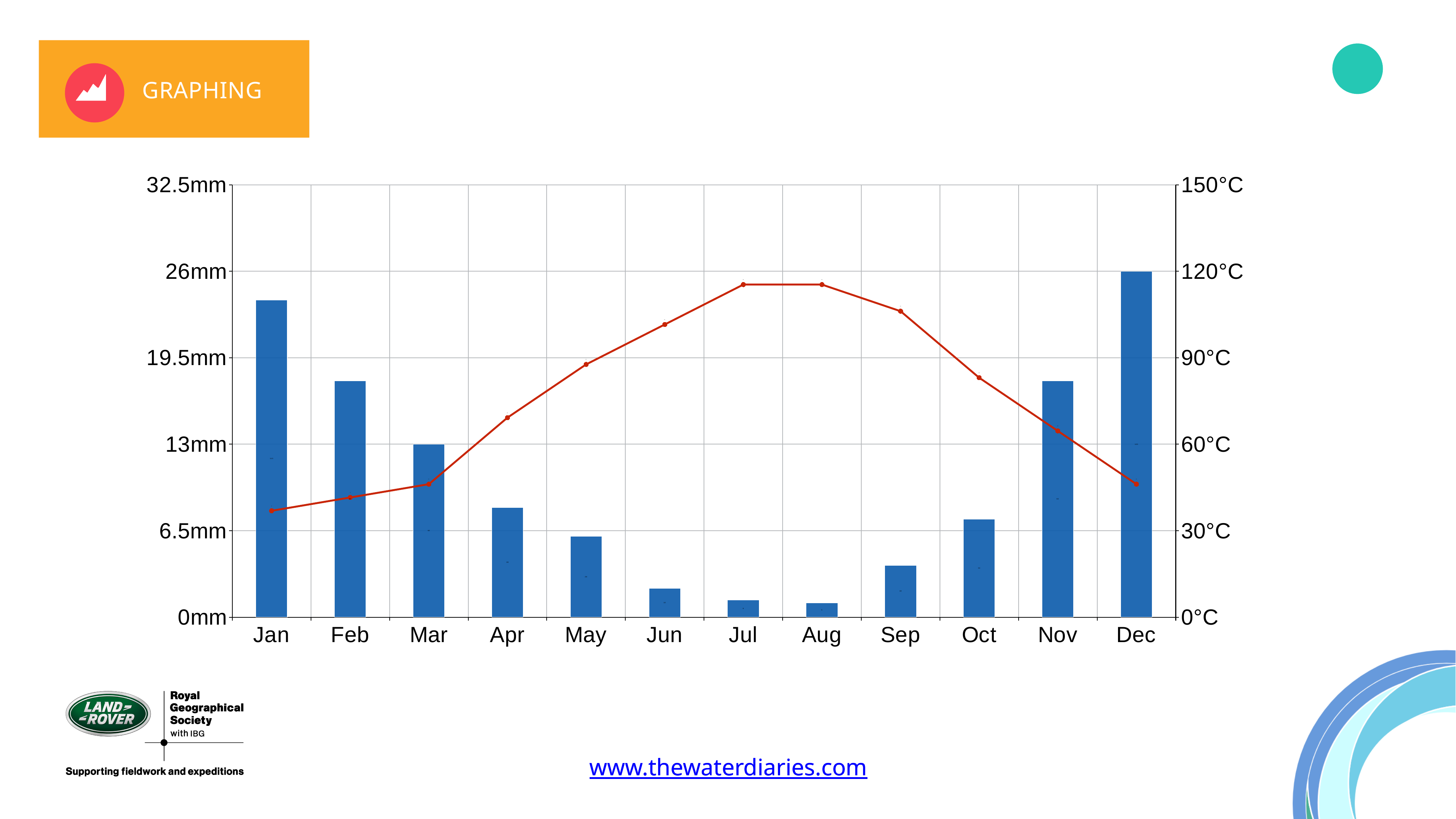
What unit is shown on the right-hand axis? °C Which month has the lowest point on the red line? Jan Is the red line value for Jul greater or less than 90°C? greater What is the bar value for Dec on the left axis? 26mm Which month has the taller bar, Jan or Feb? Jan Does the red line rise or fall from Jan to Jul? rises Is the bar value for Jan greater or less than 19.5mm? greater How many months are shown along the x axis? 12 Is the bar value for Jun greater or less than 6.5mm? less What kind of chart is shown on the slide? A combined bar and line chart Which month has the tallest bar? Dec Which month has the taller bar, Apr or Sep? Apr